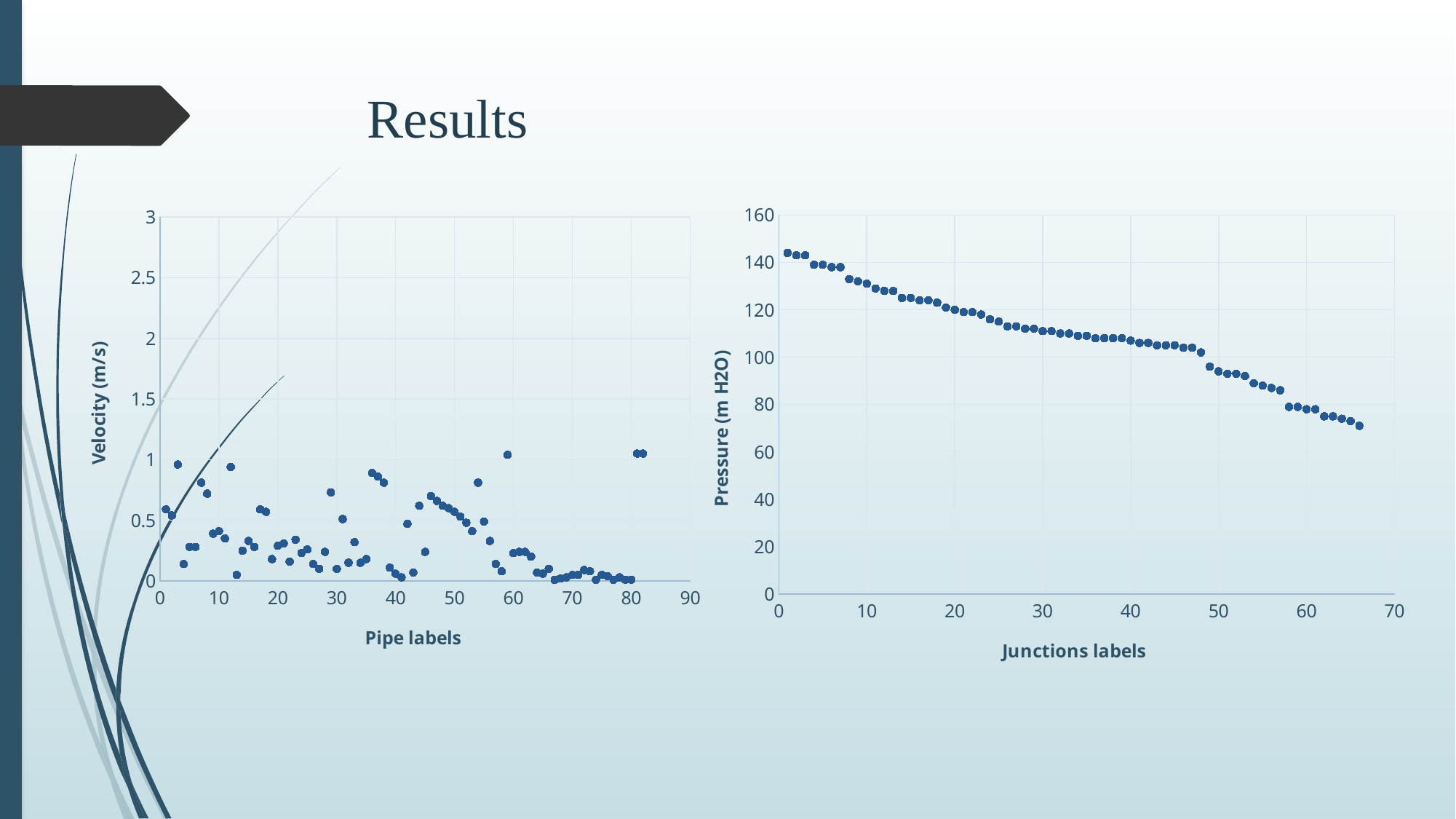
What kind of chart is the right chart (Pressure vs Junctions labels)? scatter chart In the right chart, which has the higher pressure: junction 10 or junction 60? junction 10 In the right chart, do the pressure values rise or fall as the junction label increases? fall In the right chart, which junction has the lowest pressure? 66 What is the x-axis label of the left chart? Pipe labels What is the y-axis label of the right chart? Pressure (m H2O) In the right chart, is the pressure at junction 30 greater or less than 100? greater In the right chart, is the pressure at junction 66 greater or less than 80? less What kind of chart is the left chart (Velocity vs Pipe labels)? scatter chart In the right chart, is the pressure at junction 50 greater or less than 100? less